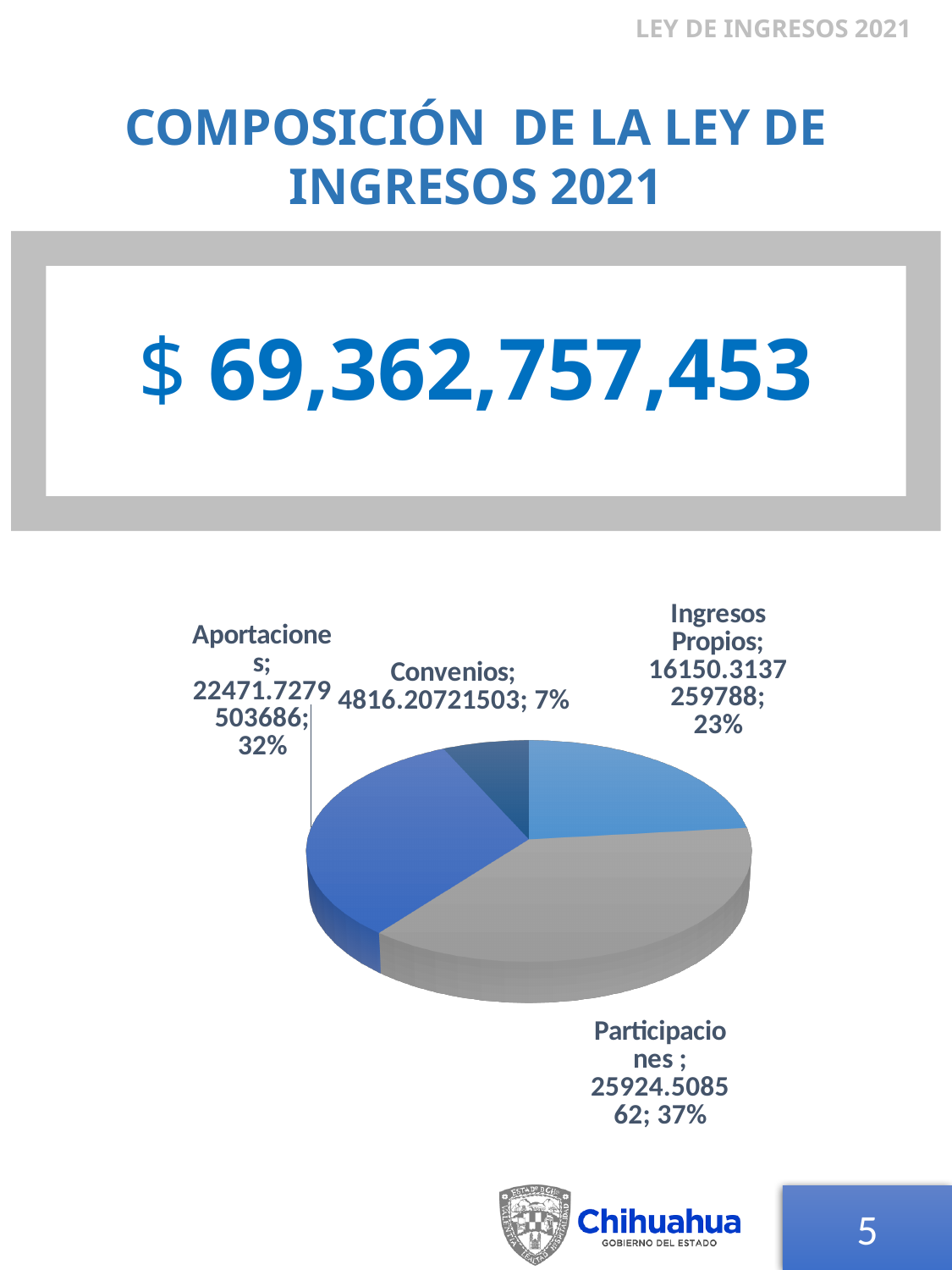
What percentage share of the pie does Aportaciones represent? 32% How many slices does the pie chart have? 4 Which category has the smallest slice of the pie? Convenios What percentage share of the pie does Convenios represent? 7% What percentage share of the pie does Participaciones represent? 37% Which has a larger share of the pie, Ingresos Propios or Aportaciones? Aportaciones What value is labelled for Convenios in the pie chart? 4816.20721503 What kind of chart is shown on the slide? pie chart What value is labelled for Participaciones in the pie chart? 25924.508562 By how many percentage points does the share of Participaciones exceed the share of Aportaciones? 5 Which category has the largest slice of the pie? Participaciones